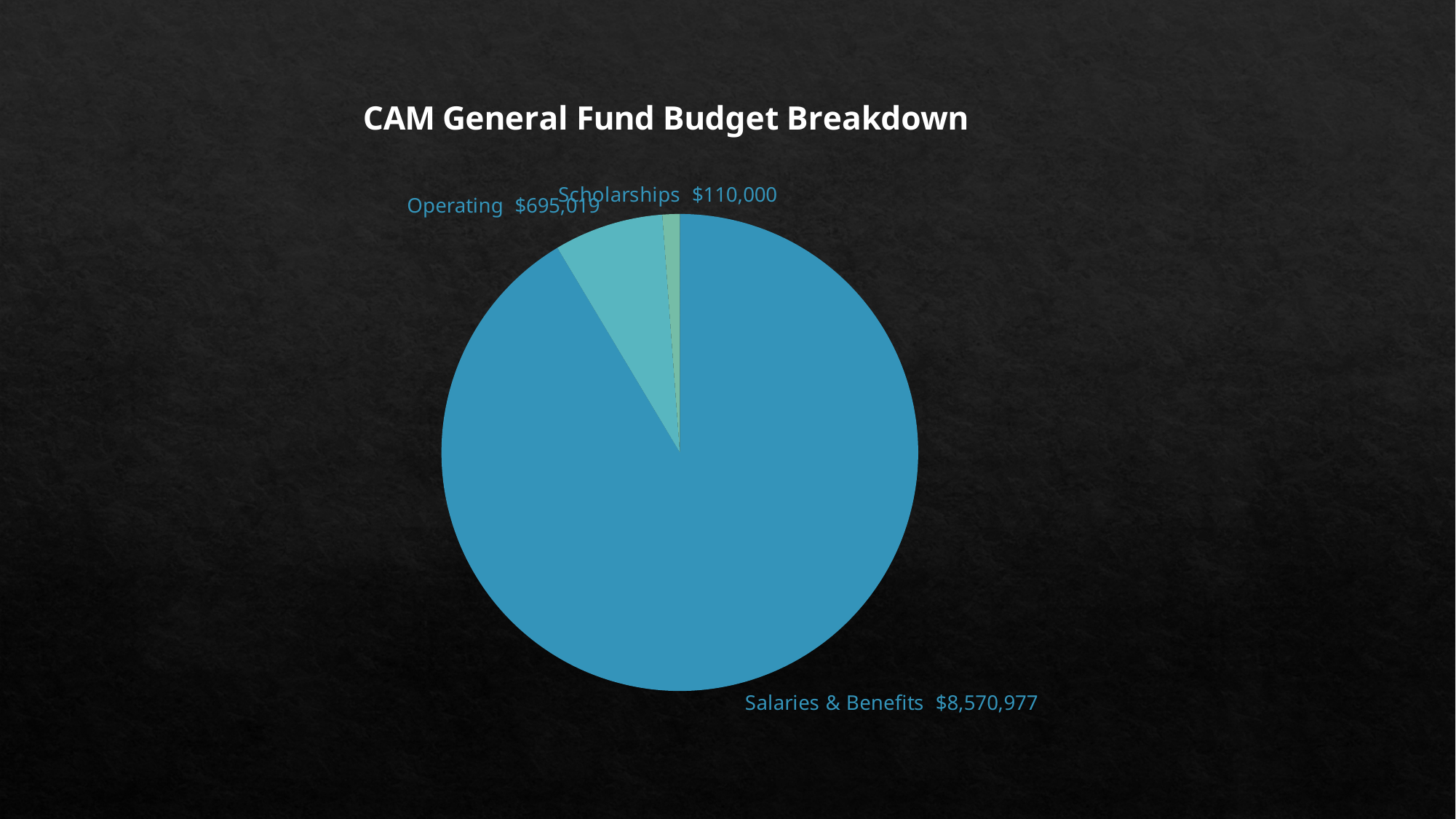
What is the difference between Operating and Scholarships? $585,019 What is the total of all three slices in the pie chart? $9,375,996 What kind of chart is shown on the slide? Pie chart How many slices does the pie chart have? 3 What is the title of the chart? CAM General Fund Budget Breakdown What is the value for Salaries & Benefits? $8,570,977 What is the difference between Salaries & Benefits and Operating? $7,875,958 Which category has the smallest slice of the pie? Scholarships Which category has the largest slice of the pie? Salaries & Benefits What is the value for Operating? $695,019 Which is larger, Operating or Scholarships? Operating What is the value for Scholarships? $110,000